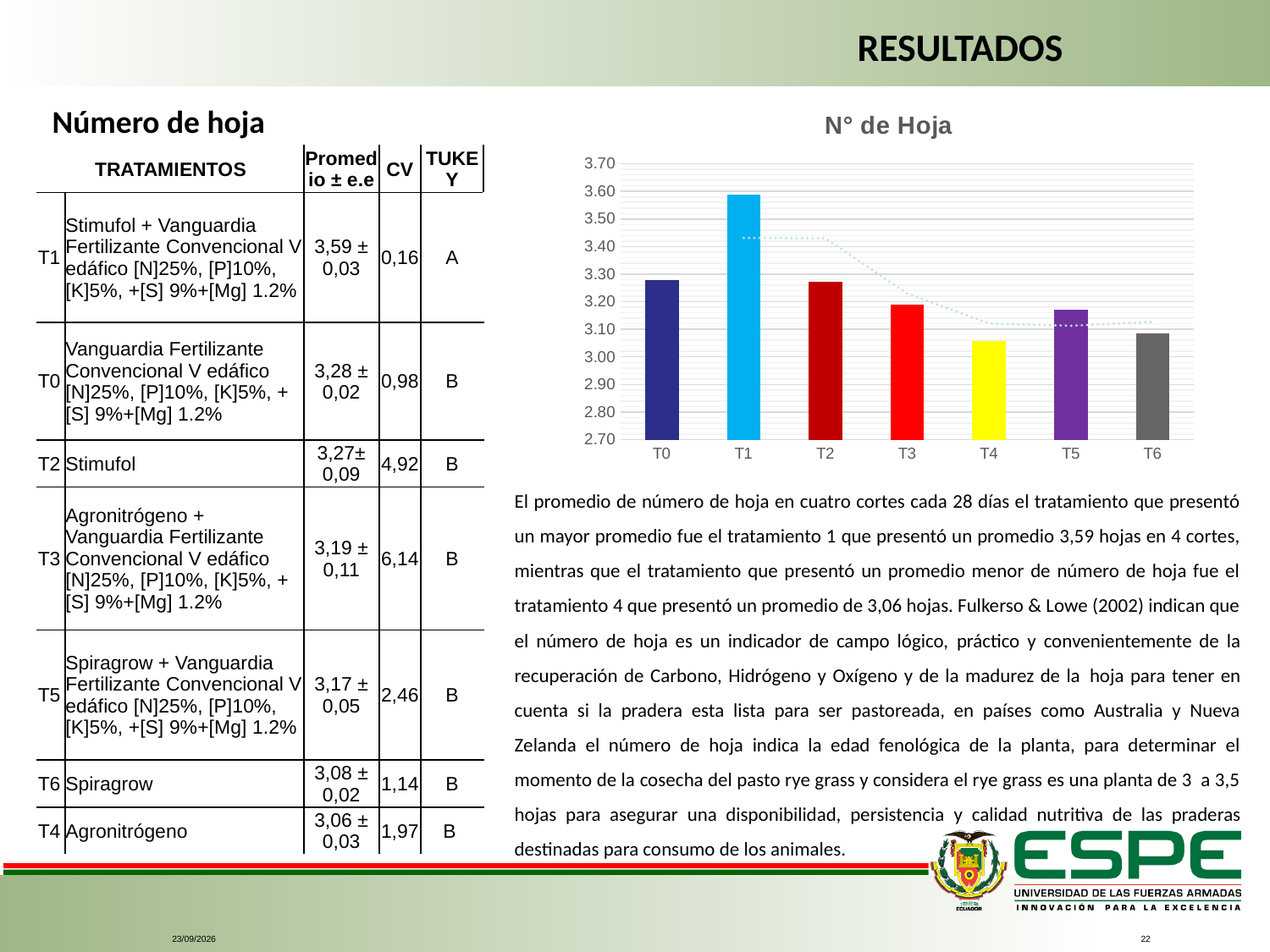
How many treatment categories are plotted on the x axis of the chart? 7 Is the value for T4 greater or less than 3.10? less Is the value for T2 greater or less than 3.20? greater Which treatment has the highest bar in the chart? T1 Which bar is taller, T1 or T0? T1 Is the value for T0 greater or less than 3.20? greater Do the bar values rise or fall from T2 to T4? fall What type of chart is shown on the slide? bar chart Which bar is taller, T2 or T6? T2 What is the title of the chart? N° de Hoja